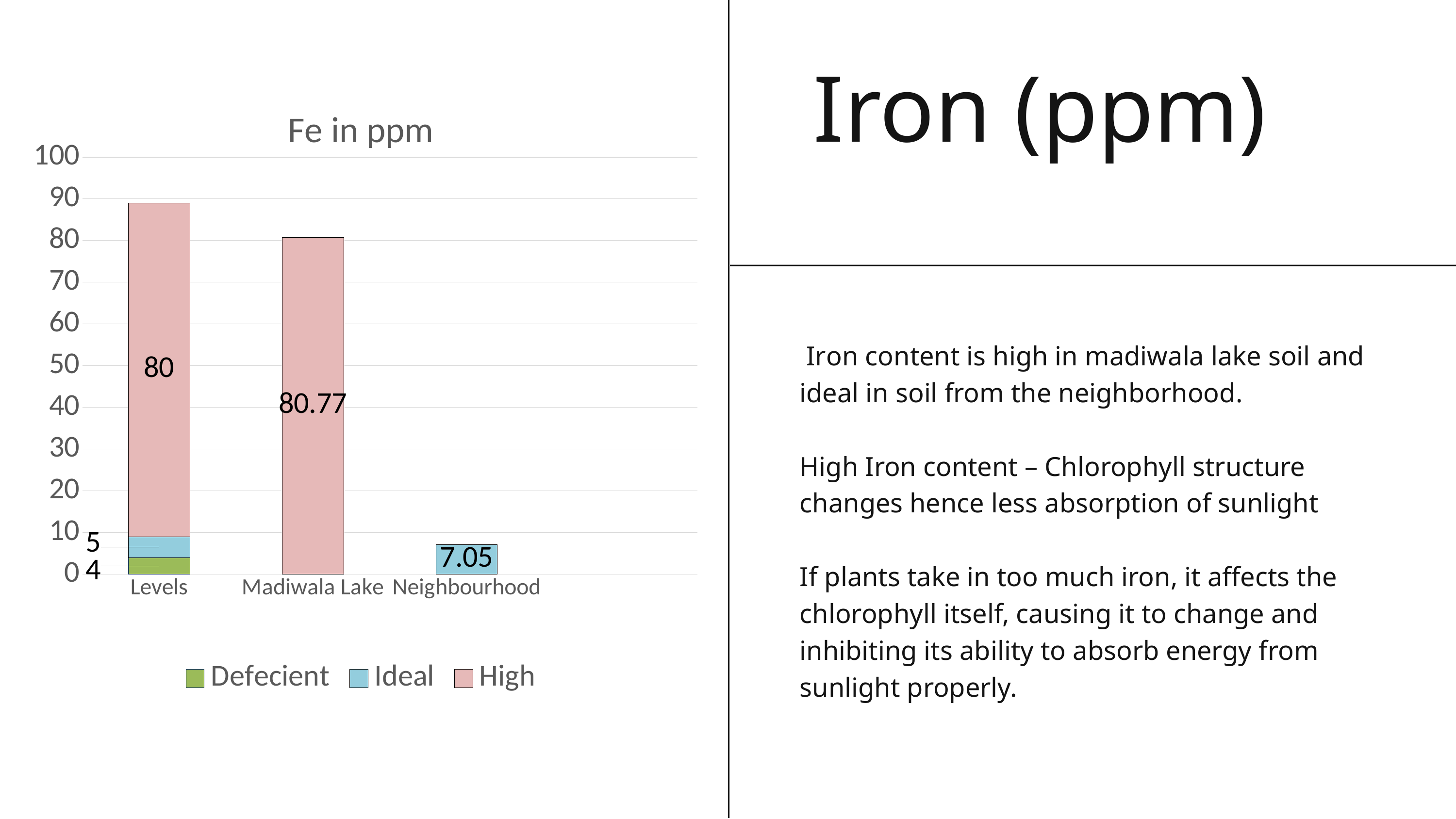
Which is larger, the Ideal value for Neighbourhood or the Ideal value for Levels? Neighbourhood What is the title of the chart? Fe in ppm What is the total of the stacked bar for Levels? 89 What is the difference between the High value for Madiwala Lake and the High value for Levels? 0.77 Which category has the tallest stacked bar overall? Levels How many categories are shown on the x axis? 3 What is the High value for Madiwala Lake? 80.77 What is the Ideal value for Levels? 5 How many series does the legend list? 3 What is the Defecient value for Levels? 4 What type of chart is shown on the slide? stacked bar chart What is the Ideal value for Neighbourhood? 7.05